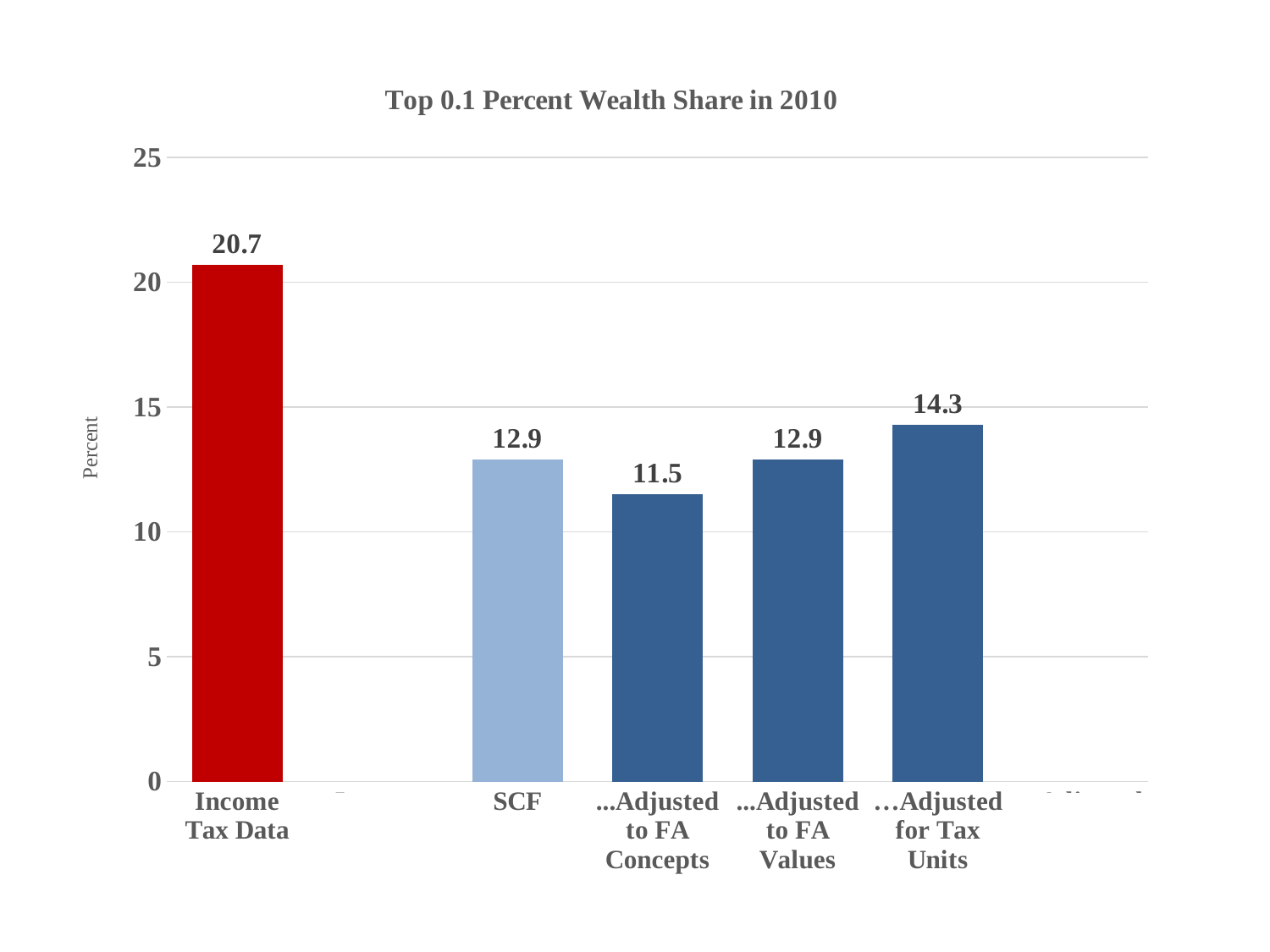
What is the difference between SCF and ...Adjusted to FA Concepts? 1.4 What is the value for SCF? 12.9 What is the value for ...Adjusted to FA Concepts? 11.5 What is the difference between Income Tax Data and ...Adjusted for Tax Units? 6.4 Is the value for Income Tax Data greater or less than 20? greater What is the value for ...Adjusted for Tax Units? 14.3 What is the value for Income Tax Data? 20.7 Which category has the highest value? Income Tax Data What kind of chart is shown? bar chart Which category has the lowest value? ...Adjusted to FA Concepts Which is larger, ...Adjusted for Tax Units or ...Adjusted to FA Values? ...Adjusted for Tax Units What is the title of the chart? Top 0.1 Percent Wealth Share in 2010